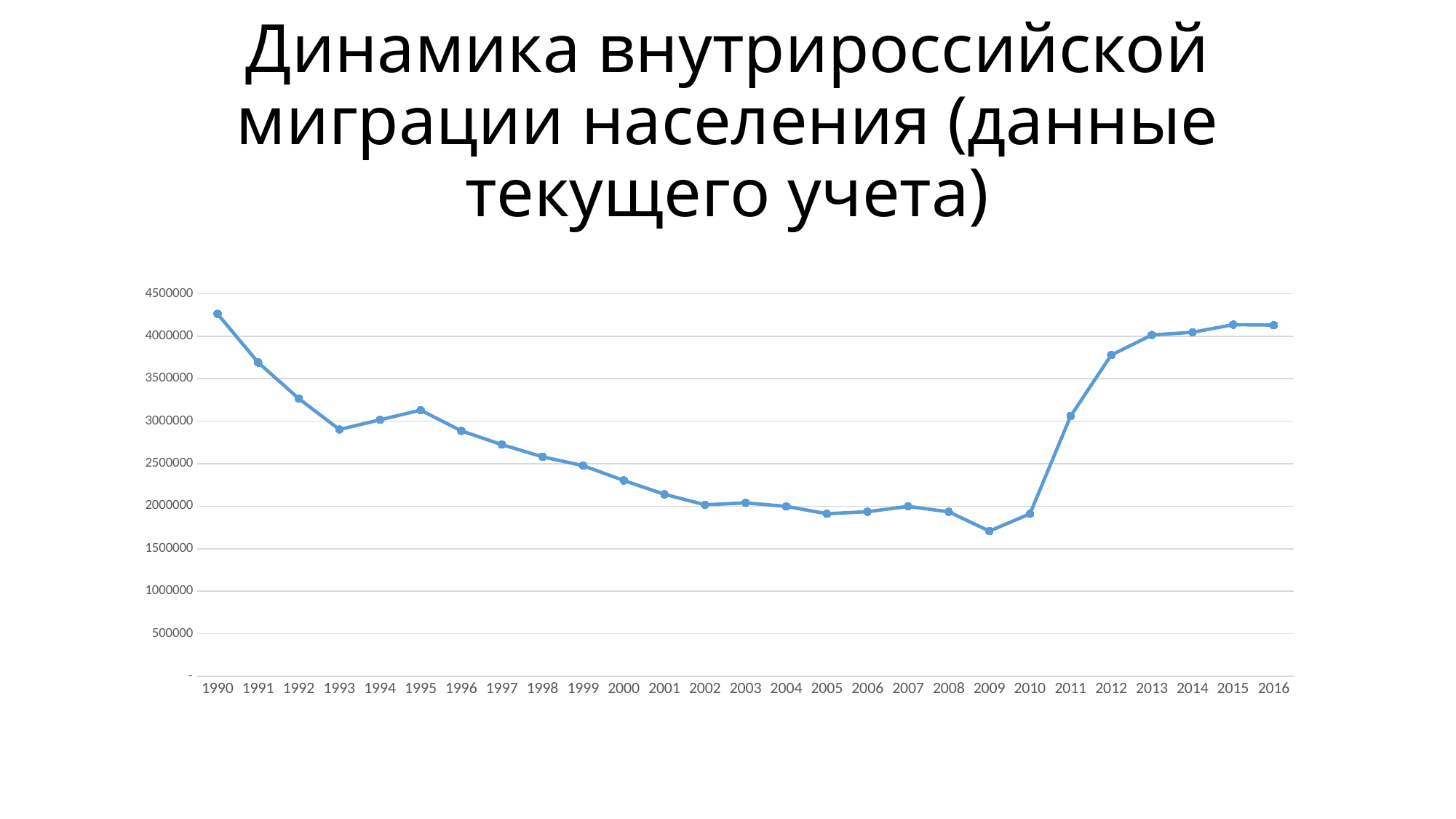
Do the values generally rise or fall from 2010 to 2016? rise Which year has the larger value, 1994 or 1995? 1995 Is the value for 1990 greater or less than 4000000? greater Is the value for 2012 greater or less than 3500000? greater Is the value for 2000 greater or less than 2500000? less Which year has the larger value, 2009 or 2010? 2010 How many years (data points) are plotted on the x axis? 27 Which year has the lowest value on the chart? 2009 Do the values generally rise or fall from 1990 to 2009? fall What kind of chart is shown on the slide? line chart Which year has the highest value on the chart? 1990